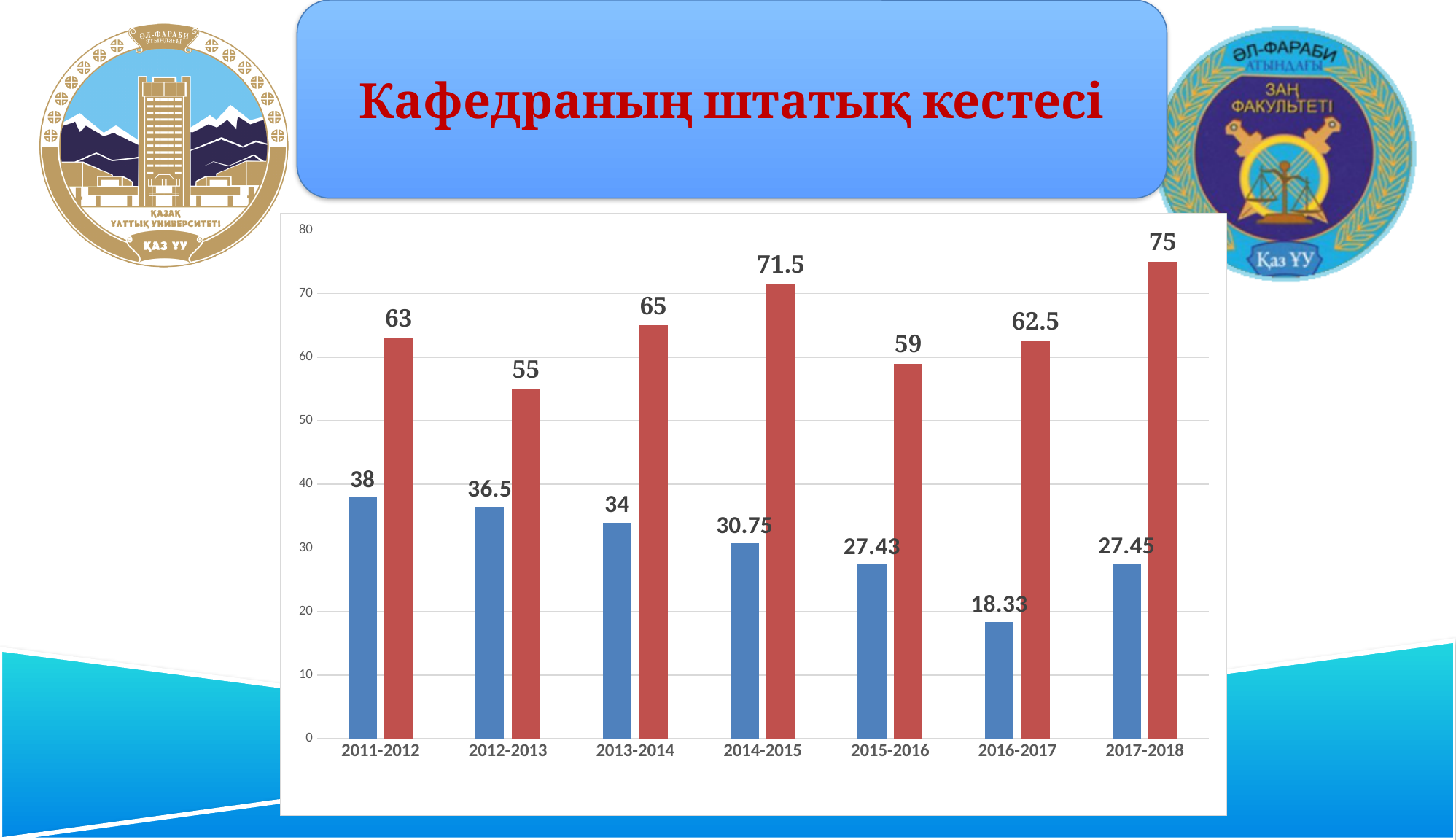
Which academic year has the lowest blue bar? 2016-2017 What is the title of the slide? Кафедраның штатық кестесі What is the difference between the red and blue bars for 2013-2014? 31 What is the value of the blue bar for 2016-2017? 18.33 What kind of chart is shown on the slide? bar chart How many academic years are shown on the x axis? 7 Is the value of the blue bar for 2014-2015 greater or less than 40? less What is the value of the blue bar for 2011-2012? 38 What is the value of the red bar for 2017-2018? 75 Which academic year has the highest red bar? 2017-2018 Which is larger, the red bar for 2012-2013 or the red bar for 2015-2016? 2015-2016 What is the value of the red bar for 2014-2015? 71.5